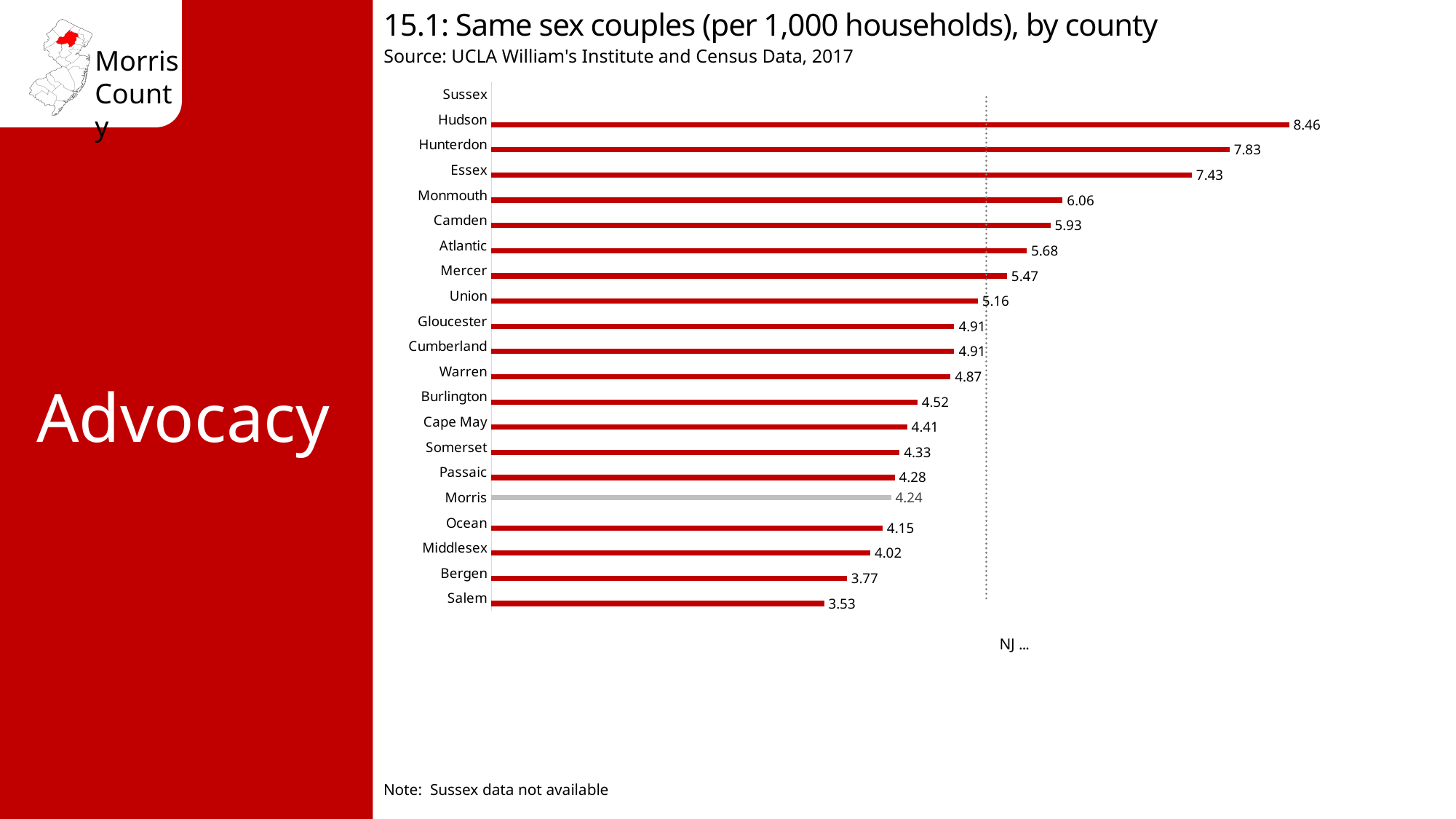
Which county has the highest value in the chart? Hudson What is the value for Salem in the chart? 3.53 Which has a larger value, Bergen or Middlesex? Middlesex What is the value for Hudson in the chart? 8.46 What is the value for Morris in the chart? 4.24 What is the difference between the values for Hudson and Salem? 4.93 Which county with a plotted bar has the lowest value in the chart? Salem What kind of chart is shown on the slide? Bar chart How many counties are listed on the vertical axis of the chart? 21 Which has a larger value, Essex or Monmouth? Essex Which county's bar is shown in grey rather than red? Morris What is the difference between the values for Hudson and Morris? 4.22